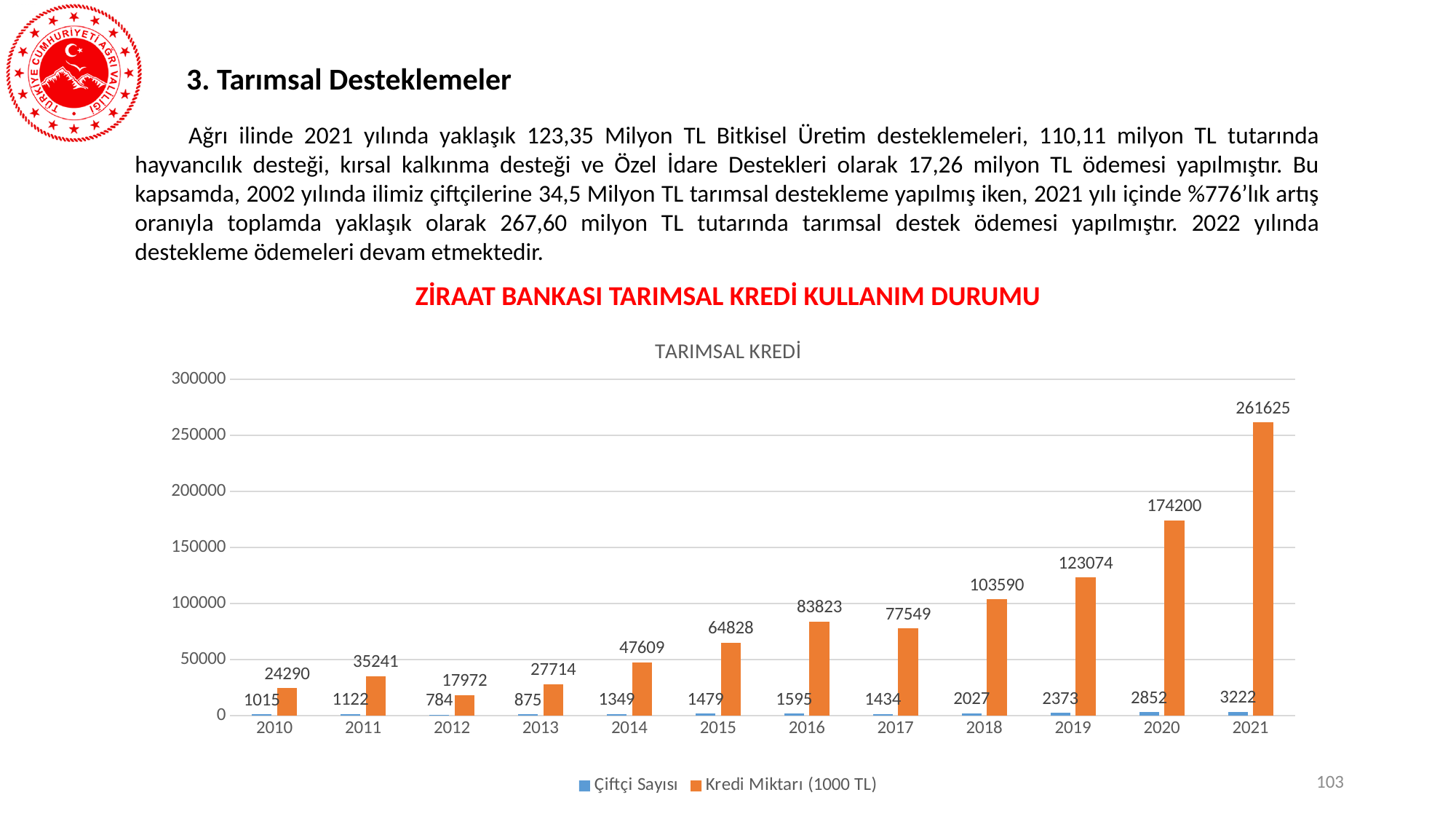
What is the Çiftçi Sayısı value for 2014? 1349 How many series does the legend of the TARIMSAL KREDİ chart list? 2 What is the Kredi Miktarı (1000 TL) value for 2021? 261625 Which year has the larger Kredi Miktarı (1000 TL) value, 2016 or 2017? 2016 What type of chart is the TARIMSAL KREDİ chart? bar chart What is the Kredi Miktarı (1000 TL) value for 2012? 17972 Is the Kredi Miktarı (1000 TL) value for 2019 greater or less than 100000? greater Which series is shown in orange in the TARIMSAL KREDİ chart? Kredi Miktarı (1000 TL) Which year has the highest Çiftçi Sayısı value? 2021 How many years are shown on the x axis of the TARIMSAL KREDİ chart? 12 What is the difference between the Kredi Miktarı (1000 TL) values for 2021 and 2020? 87425 Which year has the lowest Kredi Miktarı (1000 TL) value? 2012